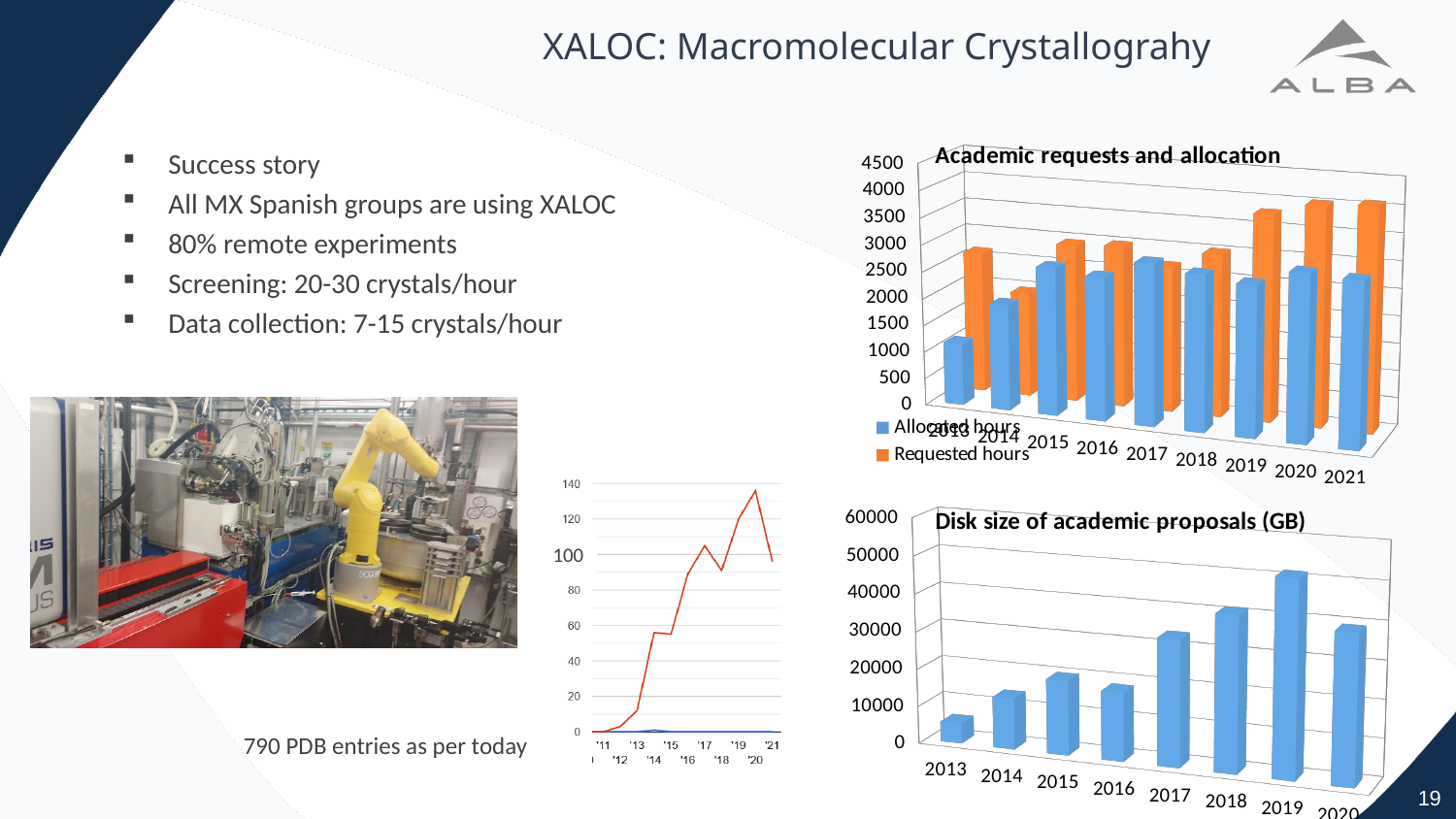
What kind of chart is the untitled chart at the bottom centre of the slide (with years '11 to '21)? line chart In the 'Disk size of academic proposals (GB)' chart, which year has the highest value? 2019 In the 'Disk size of academic proposals (GB)' chart, is the value for 2019 greater or less than 40000? greater How many series does the legend of the 'Academic requests and allocation' chart list? 2 In the 'Disk size of academic proposals (GB)' chart, which year has a larger value: 2018 or 2020? 2018 In the 'Academic requests and allocation' chart, which is larger for 2019: Requested hours or Allocated hours? Requested hours In the 'Academic requests and allocation' chart, which year has the lowest Requested hours? 2014 In the 'Academic requests and allocation' chart, is the Requested hours value for 2020 greater or less than 3000? greater In the 'Academic requests and allocation' chart, which year has the lowest Allocated hours? 2013 How many years are shown on the x axis of the 'Disk size of academic proposals (GB)' chart? 8 What kind of chart is the 'Academic requests and allocation' chart? bar chart In the 'Academic requests and allocation' chart, is the Allocated hours value for 2013 greater or less than 1500? less